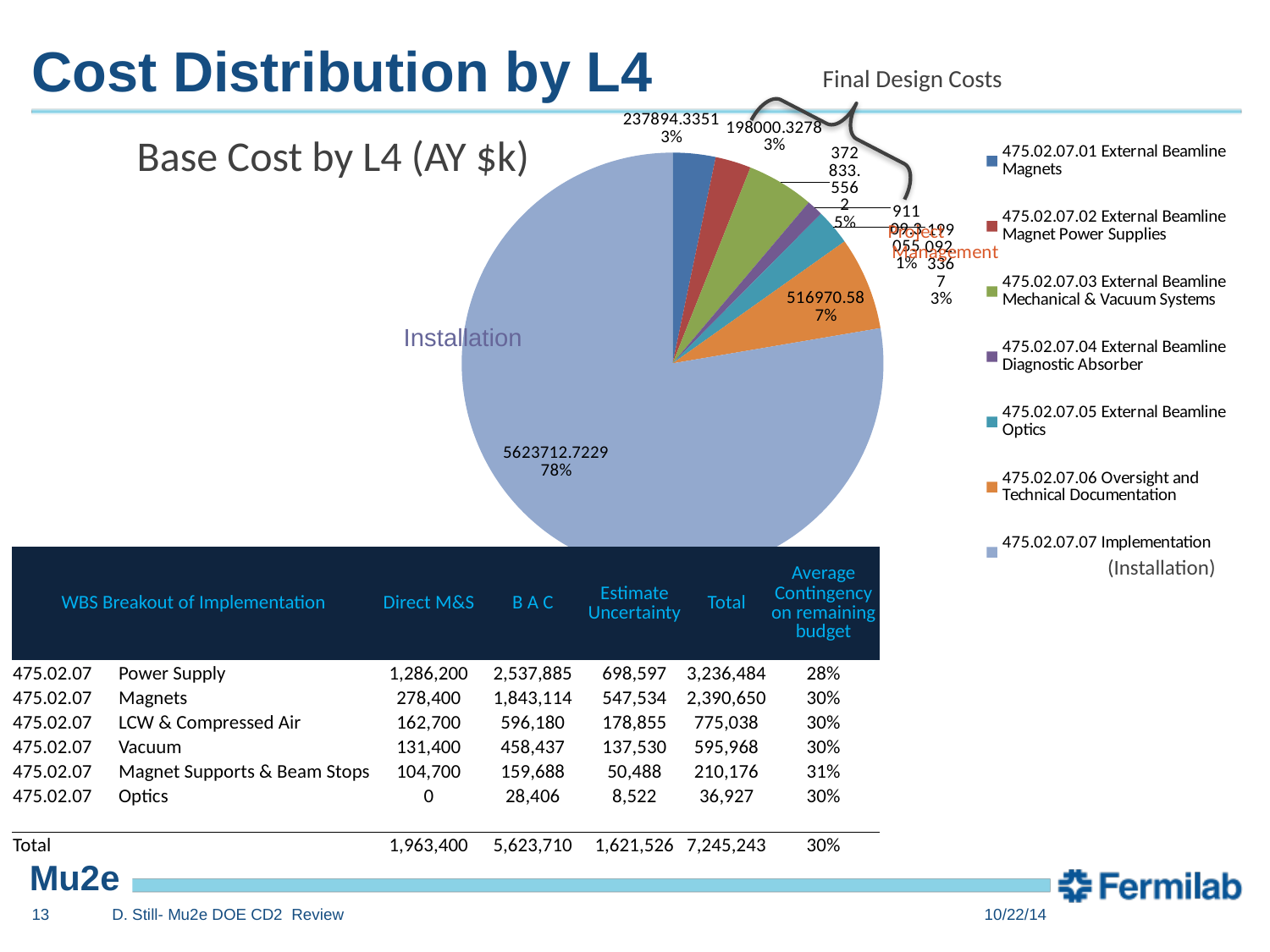
In the "Base Cost by L4 (AY $k)" pie chart, which is larger: the Oversight and Technical Documentation slice or the External Beamline Magnets slice? Oversight and Technical Documentation In the "Base Cost by L4 (AY $k)" pie chart, what value is labelled on the 475.02.07.02 External Beamline Magnet Power Supplies slice? 198000.3278 How many slices does the "Base Cost by L4 (AY $k)" pie chart have? 7 In the "Base Cost by L4 (AY $k)" pie chart, what is the difference between the Implementation (Installation) value and the Oversight and Technical Documentation value? 5106742.1429 How many entries does the legend of the "Base Cost by L4 (AY $k)" pie chart list? 7 In the "Base Cost by L4 (AY $k)" pie chart, what share of the pie does the 475.02.07.06 Oversight and Technical Documentation slice represent? 7% In the "Base Cost by L4 (AY $k)" pie chart, what value is labelled on the 475.02.07.06 Oversight and Technical Documentation slice? 516970.58 What kind of chart is the "Base Cost by L4 (AY $k)" chart? pie chart In the "Base Cost by L4 (AY $k)" pie chart, which category has the largest slice? 475.02.07.07 Implementation (Installation) In the "Base Cost by L4 (AY $k)" pie chart, what value is labelled on the 475.02.07.01 External Beamline Magnets slice? 237894.3351 In the "Base Cost by L4 (AY $k)" pie chart, what value is labelled on the Implementation (Installation) slice? 5623712.7229 In the "Base Cost by L4 (AY $k)" pie chart, what share of the pie does the Implementation (Installation) slice represent? 78%